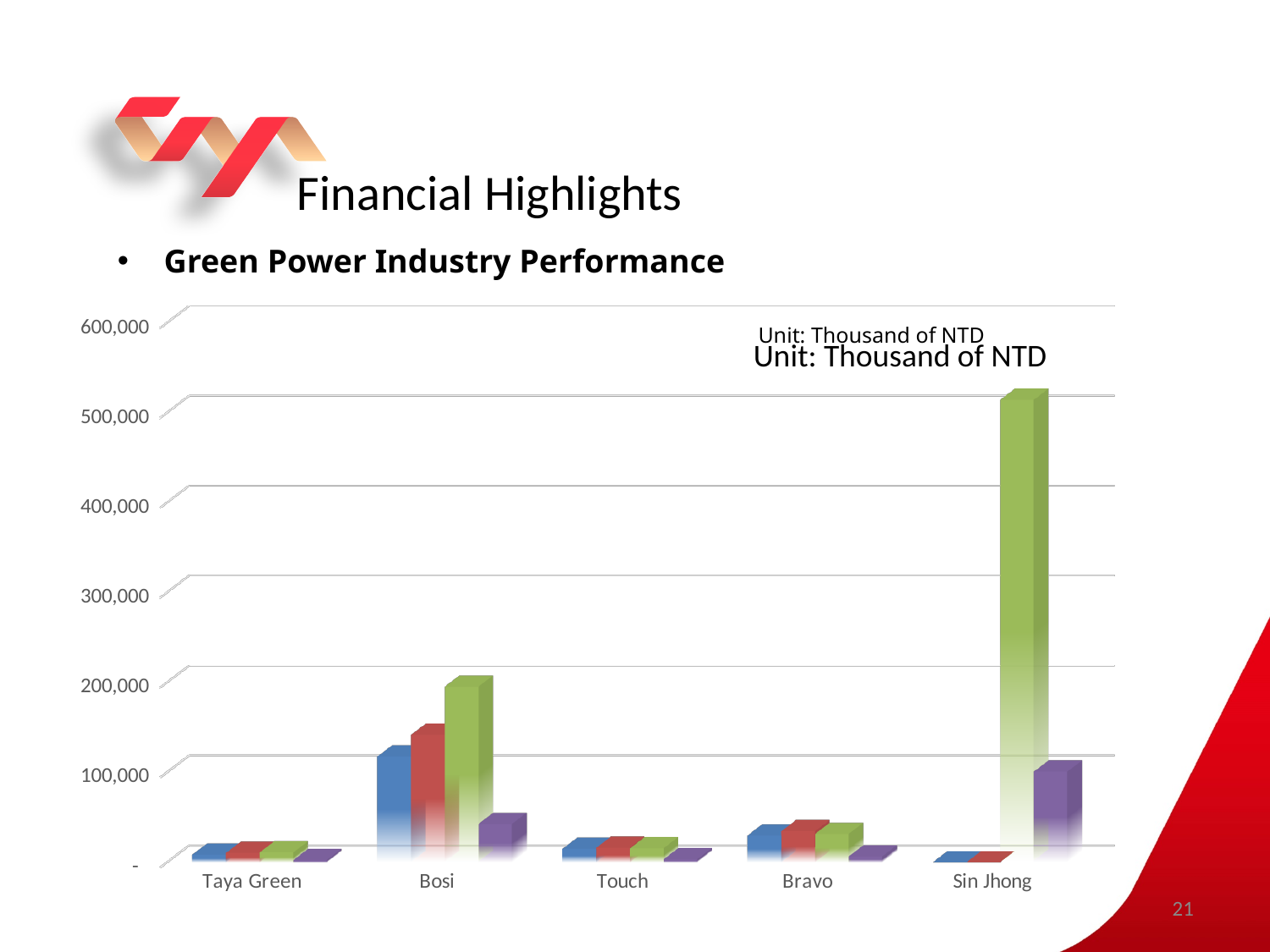
How many categories are shown on the x axis of the chart? 5 Which category has the tallest bar in the chart? Sin Jhong What is the highest value labelled on the vertical axis of the chart? 600,000 Which has the larger green bar, Sin Jhong or Bosi? Sin Jhong Is the value of the green bar for Bravo greater or less than 100,000? less How many bars are plotted for each category in the chart? 4 Is the value of the purple bar for Bosi greater or less than 100,000? less Is the value of the purple bar for Sin Jhong greater or less than 200,000? less Which has the larger green bar, Bosi or Bravo? Bosi What kind of chart is shown on the slide? bar chart What unit does the chart state its values are in? Thousand of NTD